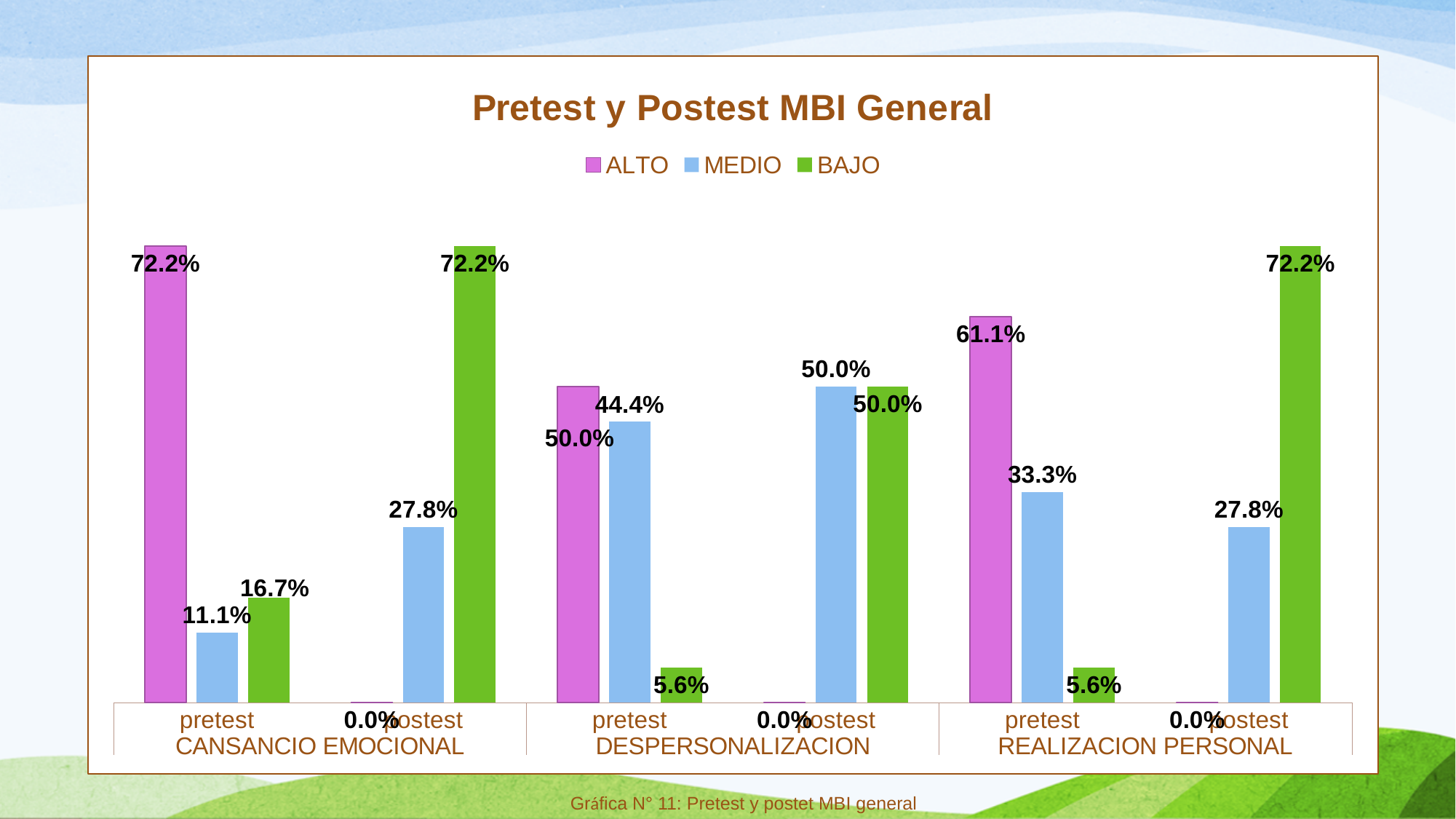
Which series has the highest value in the REALIZACION PERSONAL postest? BAJO Which is larger in the DESPERSONALIZACION pretest, the ALTO value or the MEDIO value? ALTO What is the difference between the ALTO and MEDIO values in the REALIZACION PERSONAL pretest? 27.8% What is the ALTO value for the CANSANCIO EMOCIONAL pretest? 72.2% What is the MEDIO value for the CANSANCIO EMOCIONAL postest? 27.8% Which series has the lowest value in the CANSANCIO EMOCIONAL pretest? MEDIO What is the MEDIO value for the DESPERSONALIZACION postest? 50.0% How many series does the legend list? 3 What kind of chart is shown? Bar chart What is the BAJO value for the DESPERSONALIZACION pretest? 5.6% What is the ALTO value for the REALIZACION PERSONAL pretest? 61.1% What is the title of the chart? Pretest y Postest MBI General